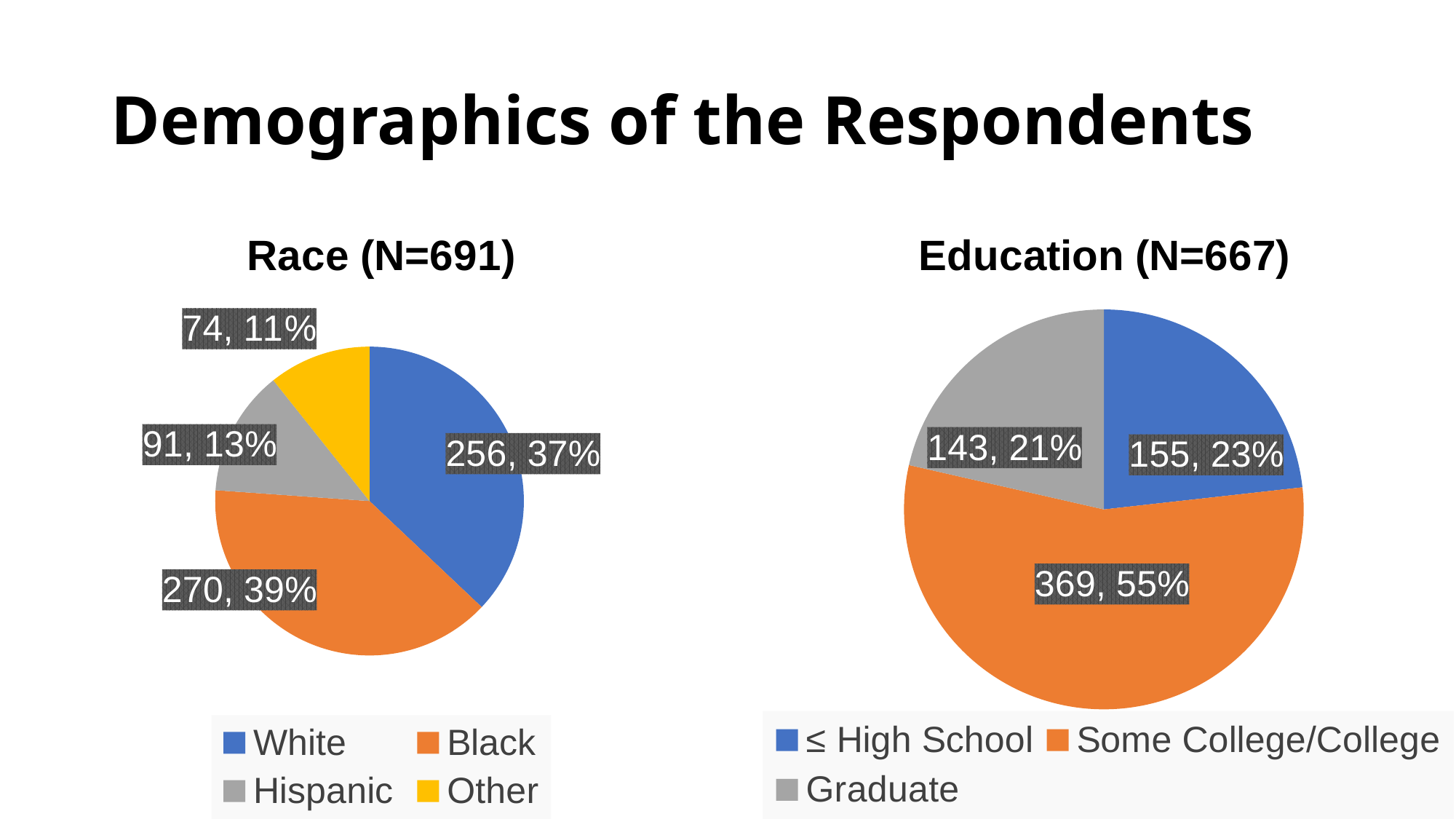
In the Race (N=691) chart, what is the difference in count between White and Hispanic respondents? 165 In the Race (N=691) chart, what percentage of respondents are Hispanic? 13% In the Race (N=691) chart, what colour is the Other slice? Yellow In the Race (N=691) chart, how many respondents are Black? 270 What type of chart is the Education (N=667) chart? Pie chart In the Education (N=667) chart, which category has the largest slice? Some College/College In the Education (N=667) chart, which is larger: ≤ High School or Graduate? ≤ High School In the Education (N=667) chart, how many respondents have Some College/College? 369 In the Race (N=691) chart, which category has the smallest slice? Other In the Education (N=667) chart, what share of the pie is Graduate? 21% In the Race (N=691) chart, how many categories are shown? 4 In the Race (N=691) chart, which category has the largest slice? Black